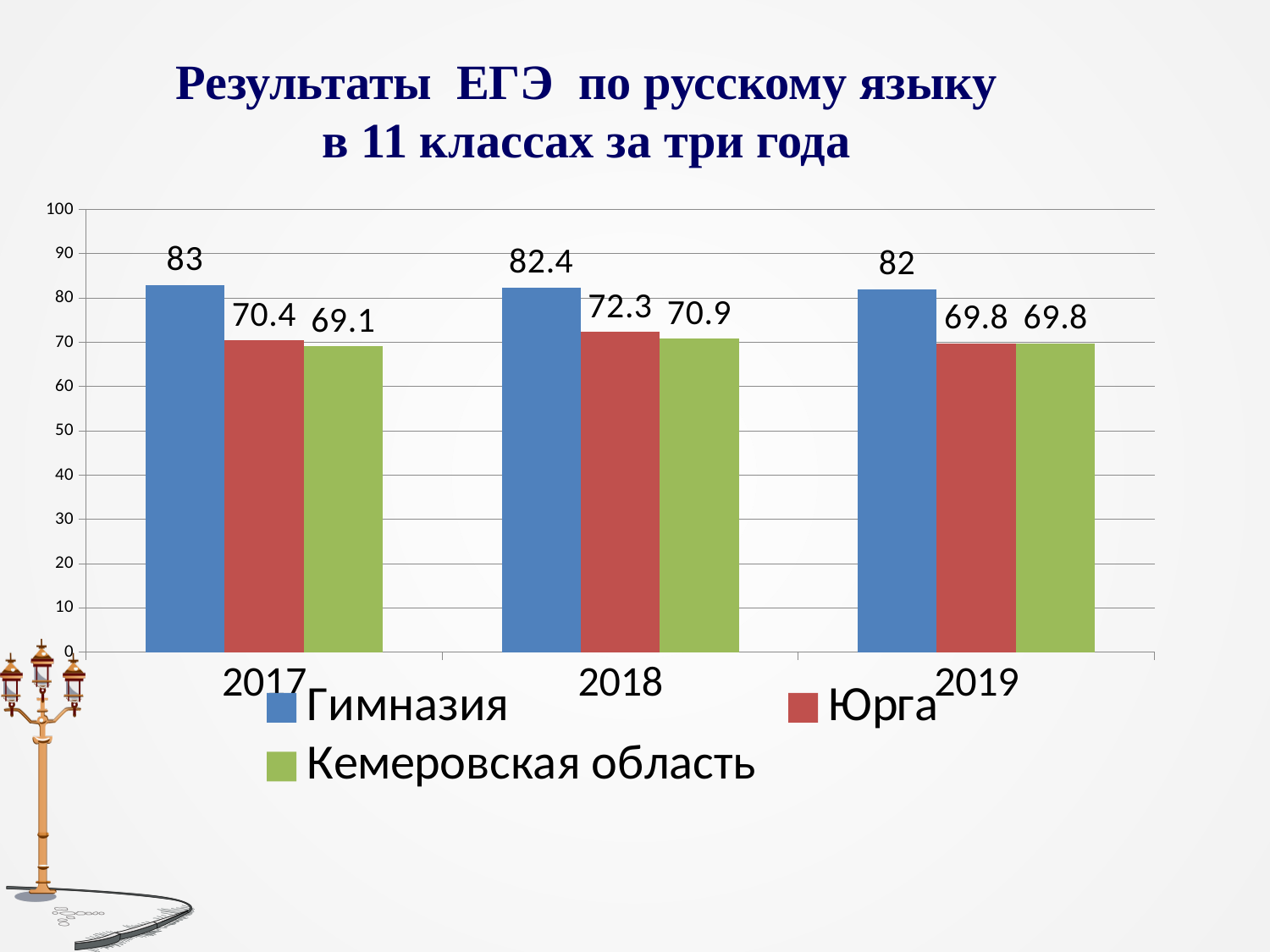
How many years are shown on the x axis? 3 What is the value for Гимназия in 2017? 83 What is the difference between the Гимназия and Юрга values in 2017? 12.6 How many series does the legend list? 3 What is the value for Кемеровская область in 2019? 69.8 Which is larger in 2018: the value for Юрга or the value for Кемеровская область? Юрга What kind of chart is shown on the slide? bar chart What is the value for Юрга in 2018? 72.3 Do the values for Гимназия rise or fall from 2017 to 2019? fall In which year is the value for Гимназия the highest? 2017 Is the value for Гимназия in 2019 greater or less than 90? less In which year is the value for Кемеровская область the lowest? 2017